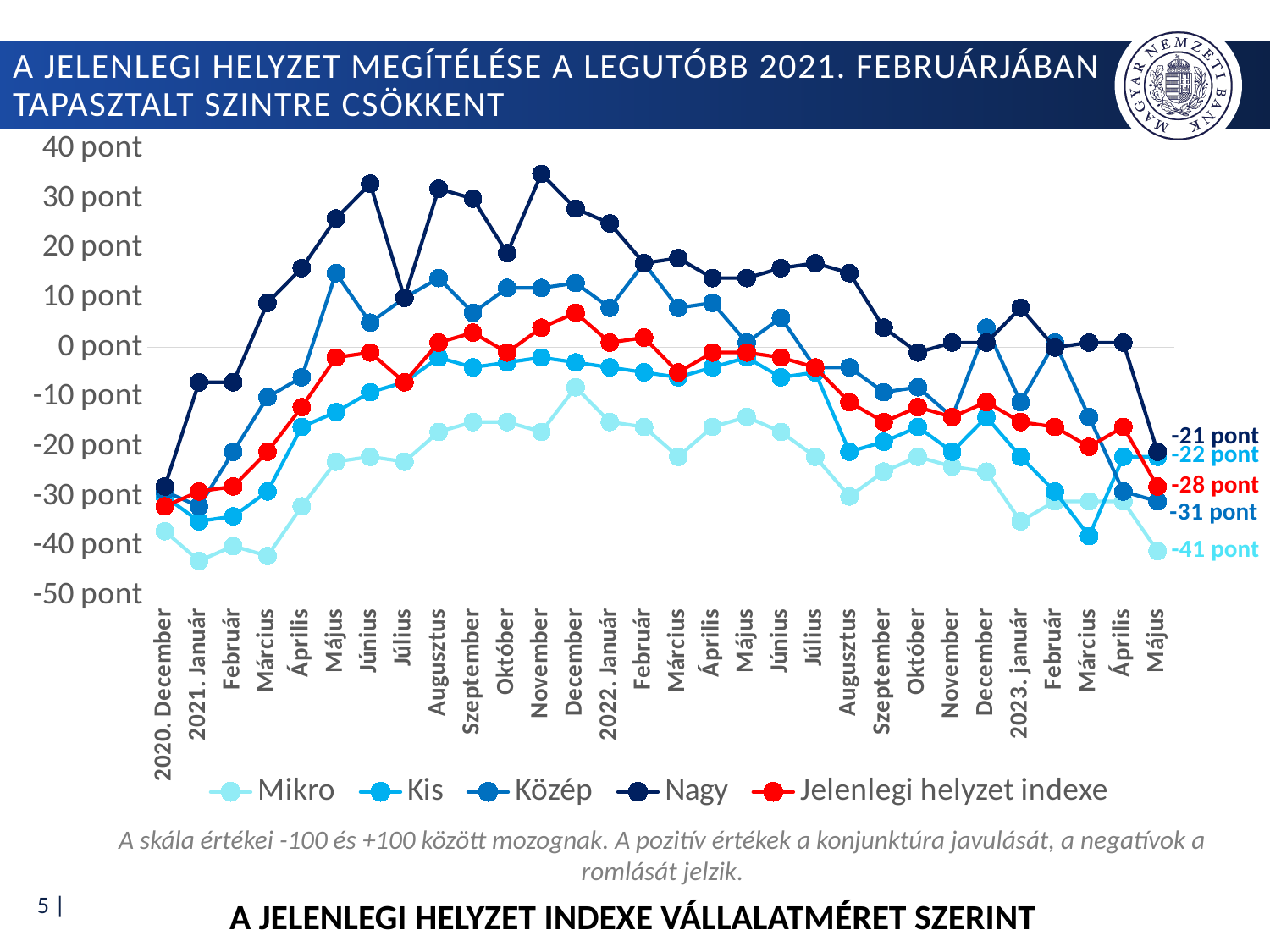
Is the value for Nagy at 2021 November greater or less than 30 pont? greater What is the value of the Nagy series at 2023 Május? -21 pont Which series has the lowest value at 2023 Május? Mikro What is the value of the Mikro series at 2023 Május? -41 pont What is the difference between the Nagy and Mikro values at 2023 Május? 20 pont What kind of chart is shown on the slide? line chart What is the value of the Közép series at 2023 Május? -31 pont How many series does the legend list? 5 How many time points are shown on the x axis? 30 What is the title of the chart shown at the bottom of the slide? A JELENLEGI HELYZET INDEXE VÁLLALATMÉRET SZERINT Is the value for Mikro at 2021 Január greater or less than -40 pont? less What is the value of the Jelenlegi helyzet indexe series at 2023 Május? -28 pont